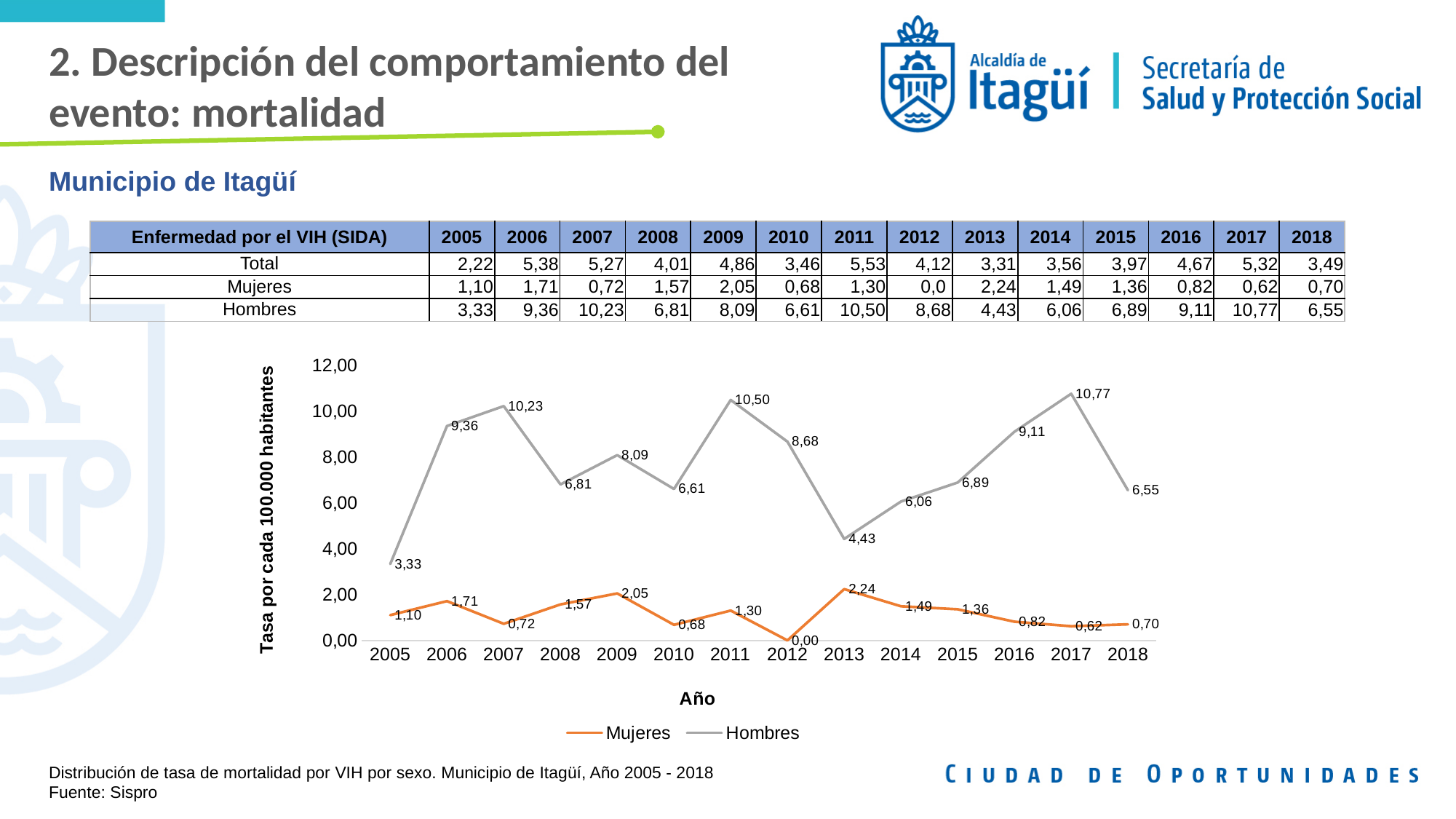
What is the difference between the Hombres and Mujeres values in 2011? 9,20 What is the value for Hombres in 2007? 10,23 Which series has the larger value in 2018, Mujeres or Hombres? Hombres How many series does the chart legend list? 2 Is the value for Hombres in 2013 greater or less than 6,00? less In which year is the Hombres series at its highest? 2017 How many years are plotted along the x axis of the chart? 14 What is the value for Mujeres in 2013? 2,24 What kind of chart is shown on the slide? line chart What is the label of the y axis of the chart? Tasa por cada 100.000 habitantes In which year is the Mujeres series at its lowest? 2012 Does the Mujeres series rise or fall from 2013 to 2017? fall